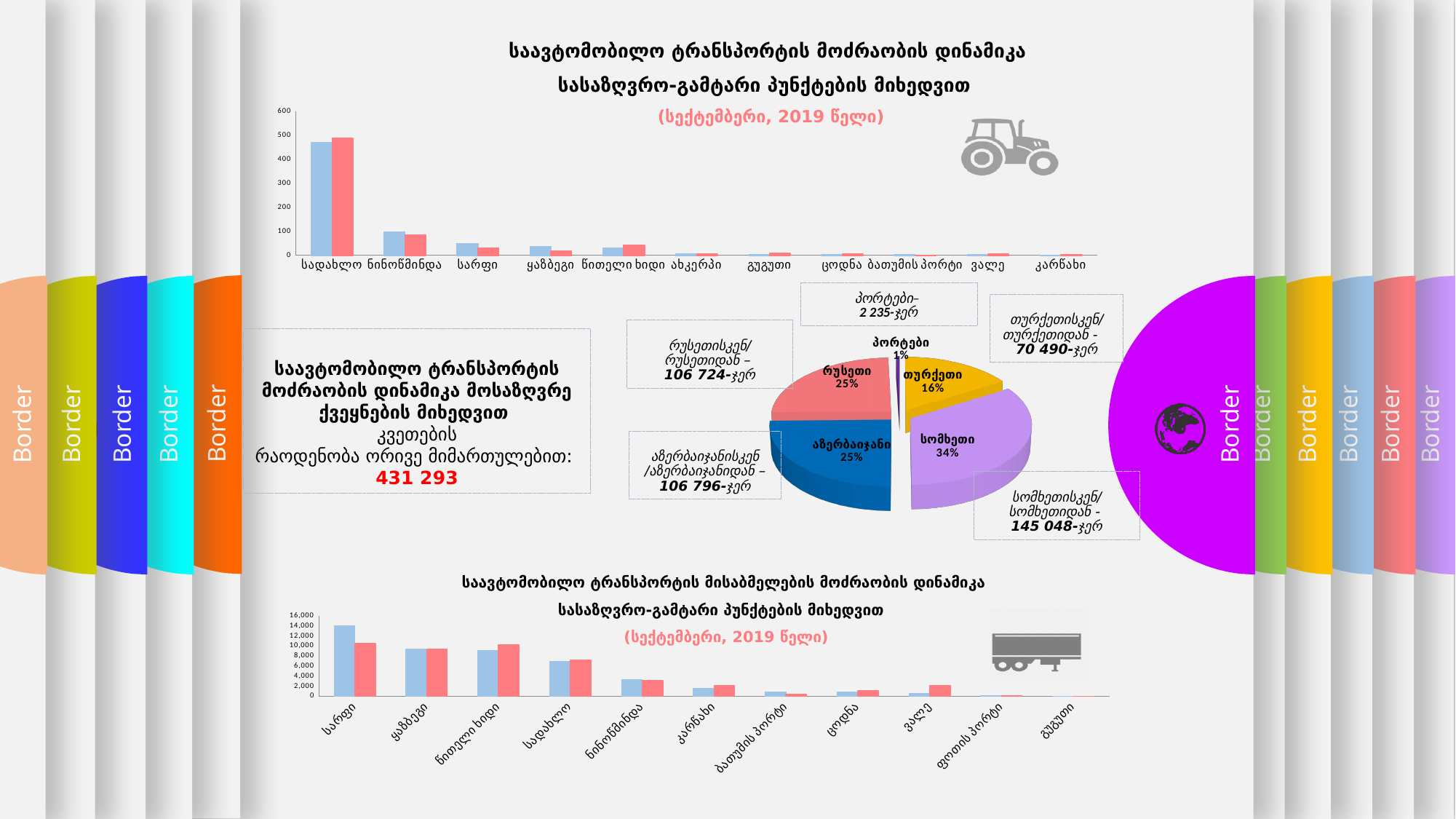
What kind of chart is the top chart on the slide? bar chart In the top bar chart, which category has the highest values? სადახლო In the bottom bar chart, is the value of the blue bar for სარფი greater or less than 12,000? greater How many categories are shown on the x axis of the top bar chart? 11 What kind of chart is the middle chart on the slide? pie chart How many slices does the pie chart have? 5 In the pie chart, what share does სომხეთი have? 34% In the pie chart, what is the difference in percentage points between სომხეთი and თურქეთი? 18% In the pie chart, which slice is the smallest? პორტები In the top bar chart, do the values generally rise or fall from left to right along the x axis? fall In the top bar chart, is the value of the blue bar for სადახლო greater or less than 400? greater In the top bar chart, which category has larger values, სადახლო or ნინოწმინდა? სადახლო